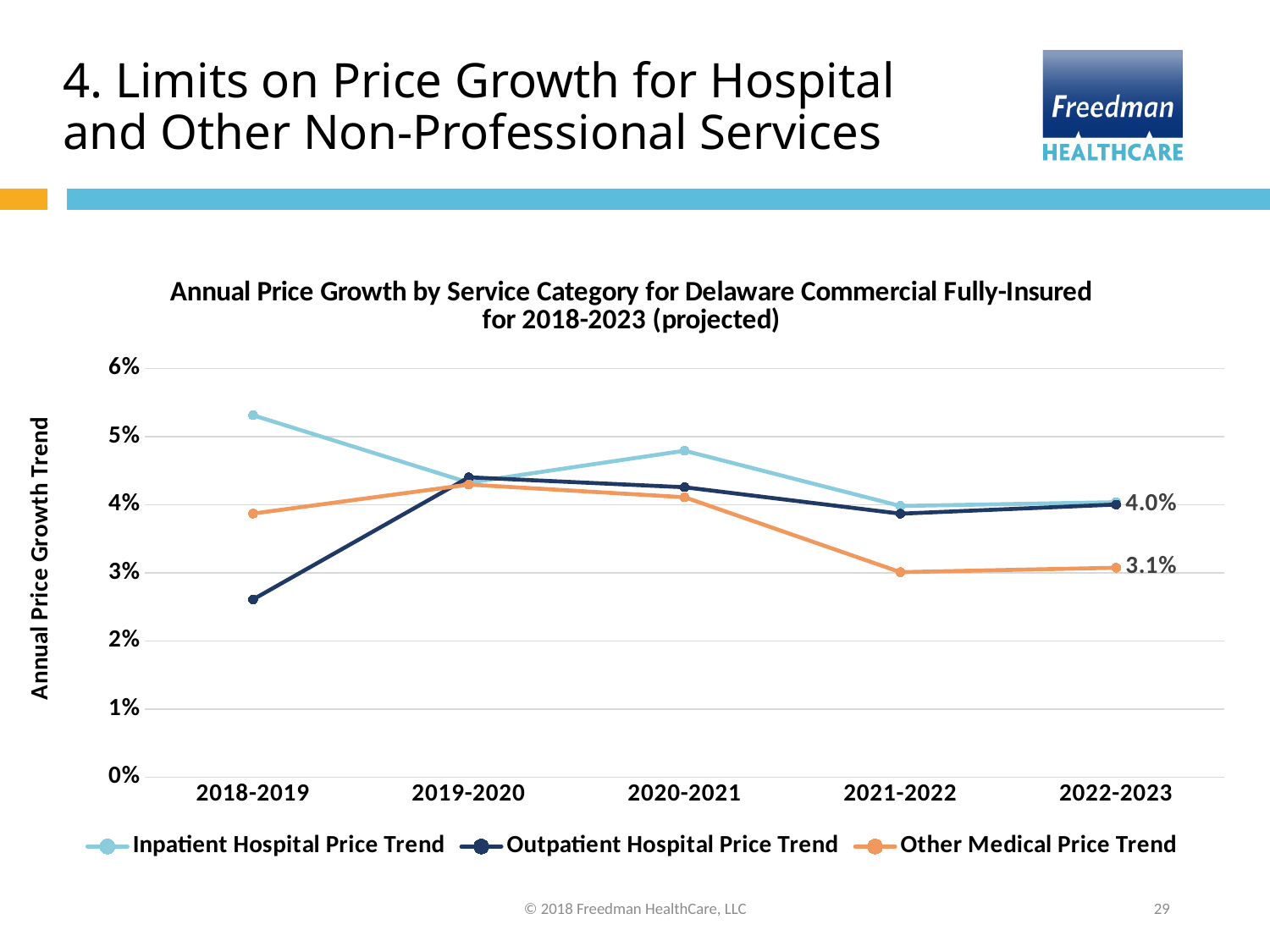
What is the difference between the Inpatient Hospital Price Trend and the Other Medical Price Trend in 2022-2023? 0.9 percentage points What is the value of the Other Medical Price Trend for 2022-2023? 3.1% Does the Outpatient Hospital Price Trend rise or fall from 2018-2019 to 2019-2020? Rise Is the value of the Inpatient Hospital Price Trend for 2018-2019 greater or less than 5%? greater Which series has the highest value in 2018-2019? Inpatient Hospital Price Trend In 2022-2023, which is larger: the Inpatient Hospital Price Trend or the Other Medical Price Trend? Inpatient Hospital Price Trend What is the value of the Inpatient Hospital Price Trend for 2022-2023? 4.0% Which series has the lowest value in 2018-2019? Outpatient Hospital Price Trend How many series does the legend list? 3 How many time periods are shown on the x axis? 5 Is the value of the Outpatient Hospital Price Trend for 2018-2019 greater or less than 3%? less What kind of chart is shown on the slide? Line chart